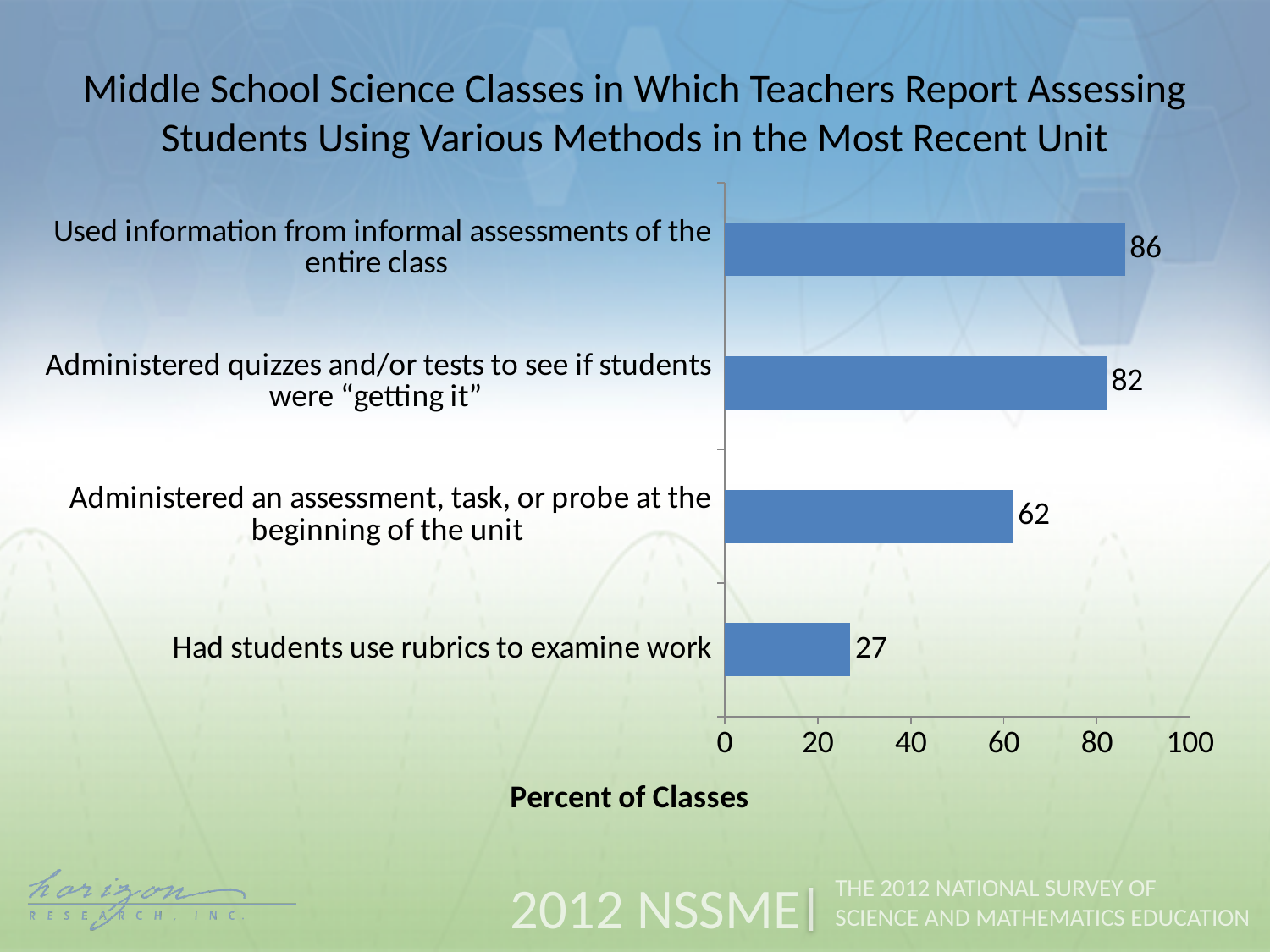
Which assessment method has the lowest percent of classes? Had students use rubrics to examine work Which has a higher percent of classes: administering an assessment, task, or probe at the beginning of the unit, or having students use rubrics to examine work? Administered an assessment, task, or probe at the beginning of the unit What percent of classes had students use rubrics to examine work? 27 How many assessment methods are shown in the chart? 4 What kind of chart is shown on the slide? Bar chart What percent of classes administered an assessment, task, or probe at the beginning of the unit? 62 What percent of classes used information from informal assessments of the entire class? 86 Which assessment method has the highest percent of classes? Used information from informal assessments of the entire class What is the difference in percent of classes between administering quizzes and/or tests and administering an assessment, task, or probe at the beginning of the unit? 20 What percent of classes administered quizzes and/or tests to see if students were "getting it"? 82 What is the difference in percent of classes between using information from informal assessments of the entire class and having students use rubrics to examine work? 59 What is the label of the horizontal axis? Percent of Classes